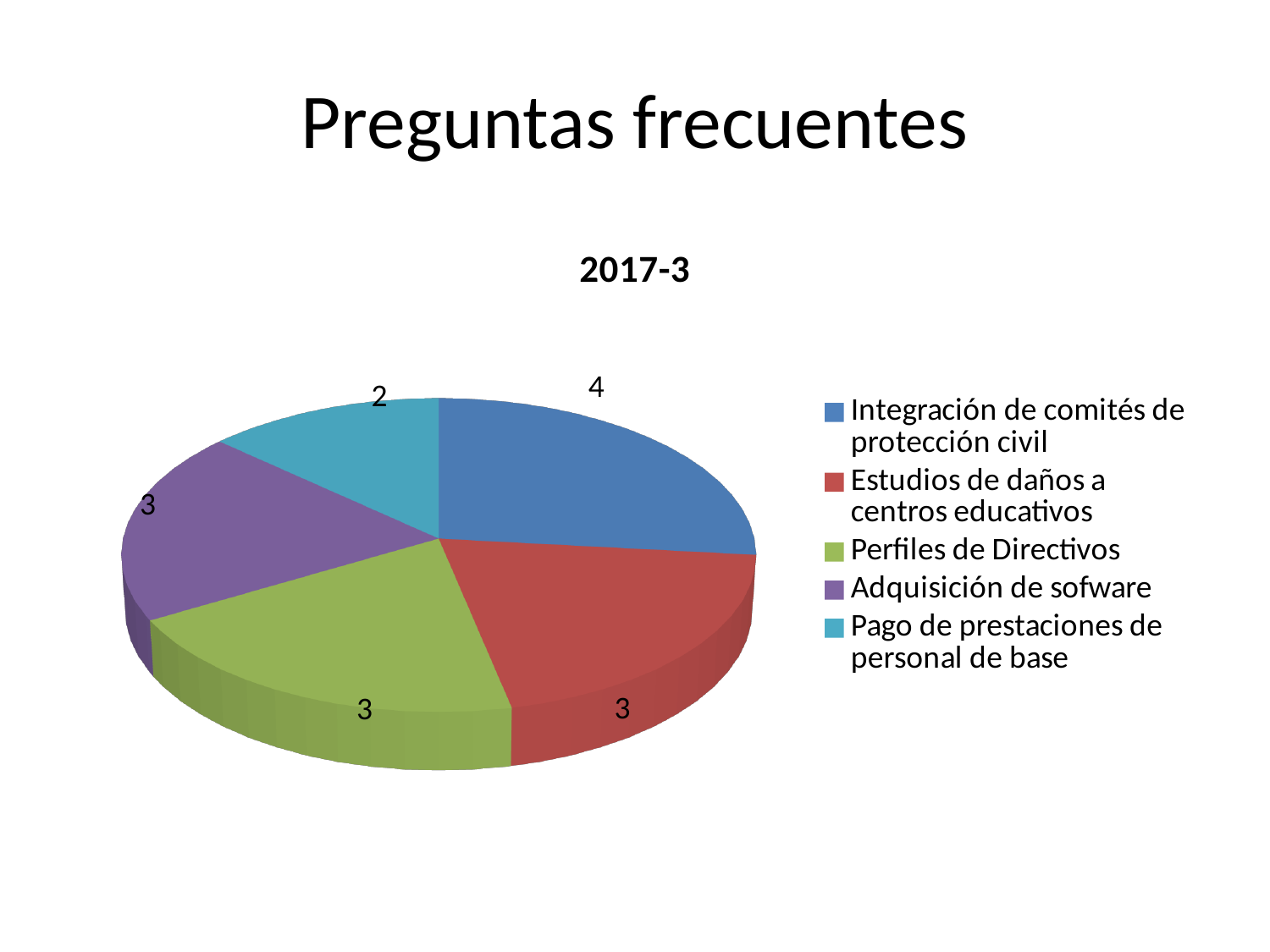
Which category has the largest slice of the pie? Integración de comités de protección civil What is the title of the chart? 2017-3 What share of the pie does Perfiles de Directivos represent? 20% Which is larger, the value for Estudios de daños a centros educativos or the value for Pago de prestaciones de personal de base? Estudios de daños a centros educativos What is the value for Pago de prestaciones de personal de base? 2 How many slices does the pie chart have? 5 What is the value for Perfiles de Directivos? 3 What is the value for Integración de comités de protección civil? 4 What type of chart is shown on the slide? pie chart Which category has the smallest slice of the pie? Pago de prestaciones de personal de base What is the difference between the value for Integración de comités de protección civil and the value for Pago de prestaciones de personal de base? 2 What is the total of all the slices in the pie chart? 15